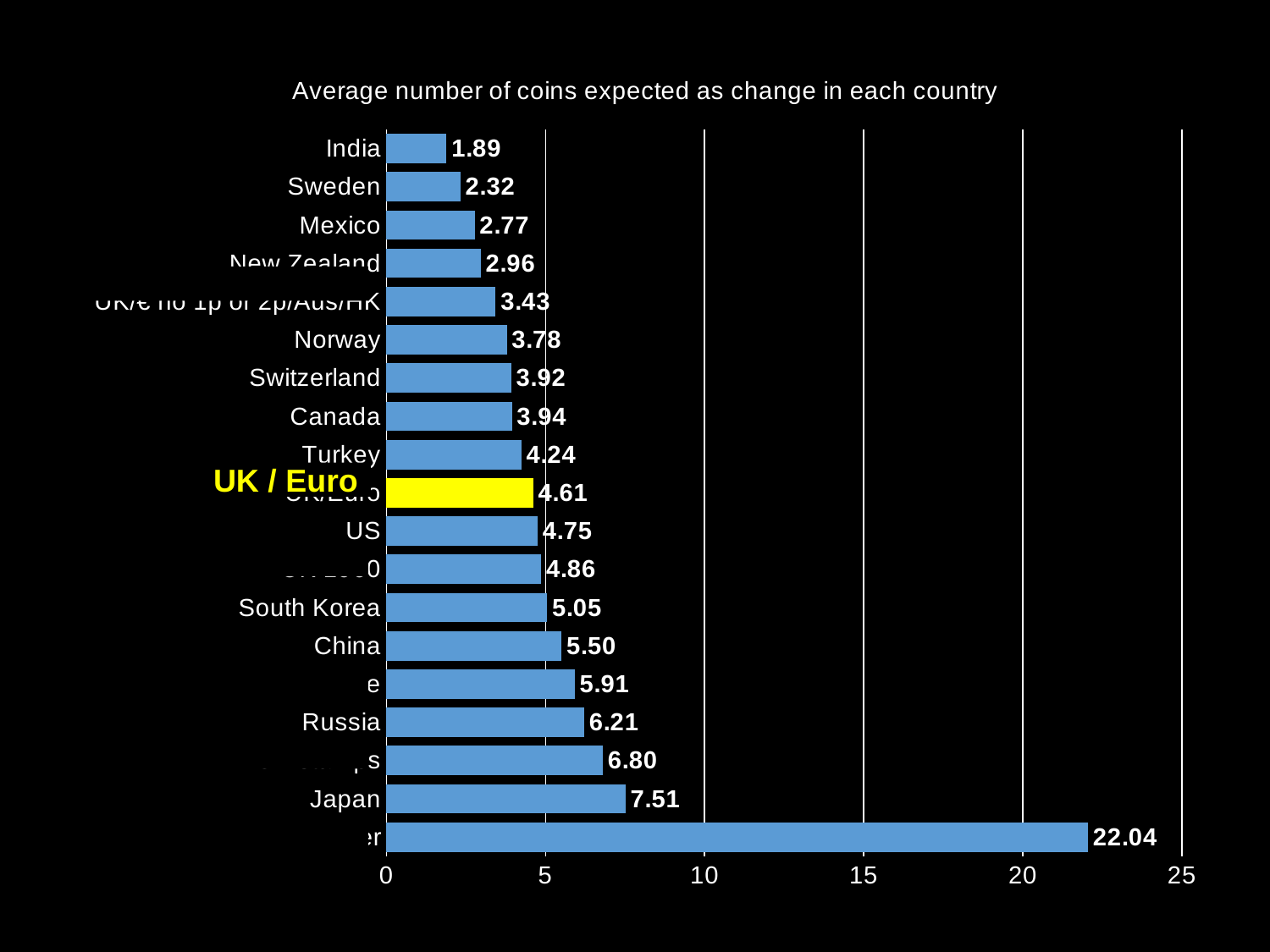
What is the value for the UK / Euro bar? 4.61 How many bars are plotted in the chart? 19 What is the value for South Korea? 5.05 What is the difference between the values for China and Sweden? 3.18 Which has a higher value, Mexico or Canada? Canada Which country has the lowest average number of coins expected as change? India What is the value for Japan? 7.51 What type of chart is shown on the slide? Bar chart What is the value for India? 1.89 Which has a higher value, Norway or Turkey? Turkey Is the value for Japan greater or less than 10? less What is the difference between the values for Japan and Russia? 1.30